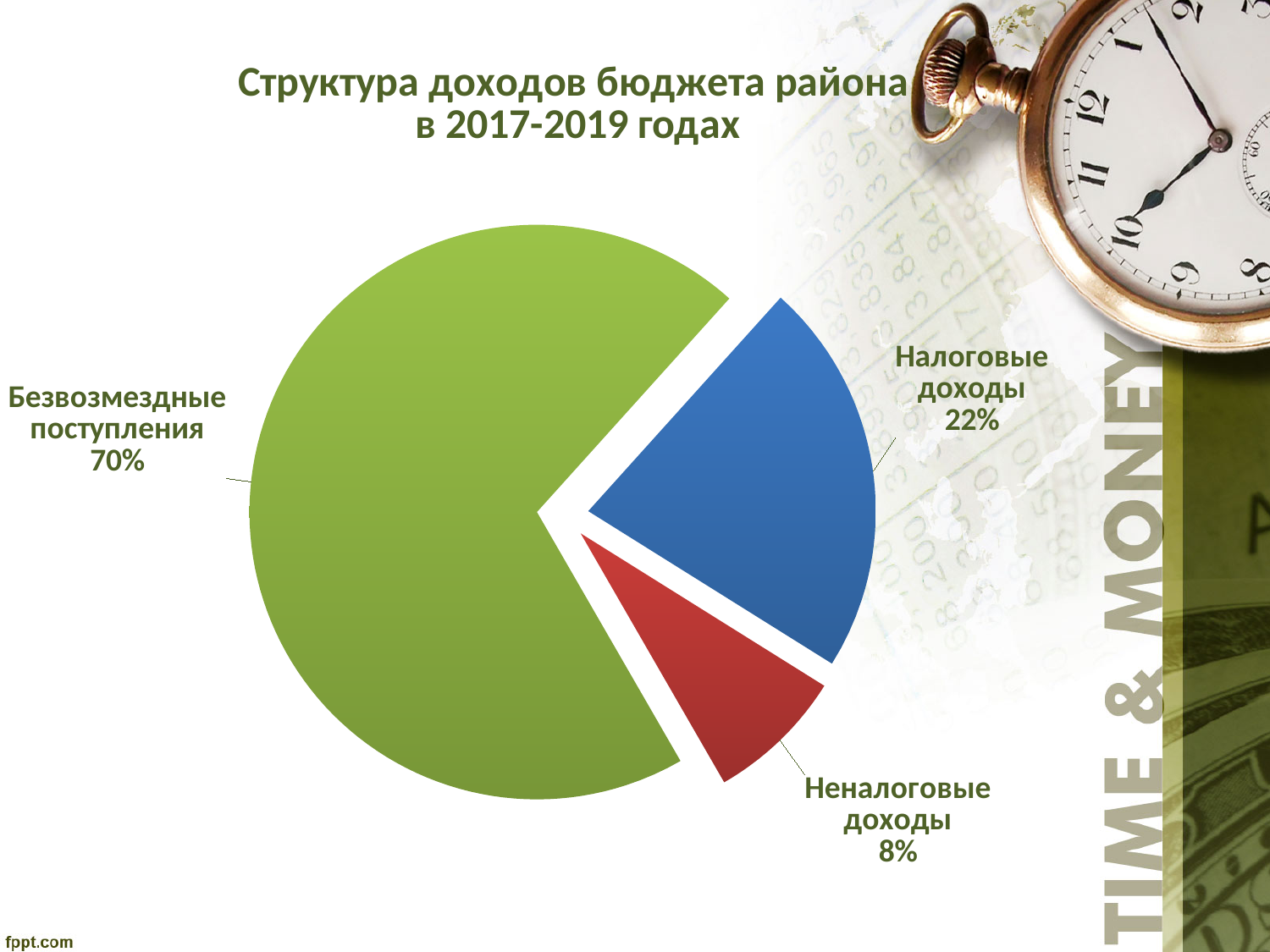
What colour is the slice for Налоговые доходы? blue What share of the pie does Безвозмездные поступления have? 70% Which is larger, Налоговые доходы or Неналоговые доходы? Налоговые доходы What share of the pie does Налоговые доходы have? 22% Which category has the smallest slice of the pie? Неналоговые доходы Which category has the largest slice of the pie? Безвозмездные поступления What share of the pie does Неналоговые доходы have? 8% What is the title of the chart on the slide? Структура доходов бюджета района в 2017-2019 годах What is the difference in percentage points between Налоговые доходы and Неналоговые доходы? 14 What kind of chart is shown on the slide? pie chart What is the difference in percentage points between Безвозмездные поступления and Налоговые доходы? 48 How many slices does the pie chart have? 3